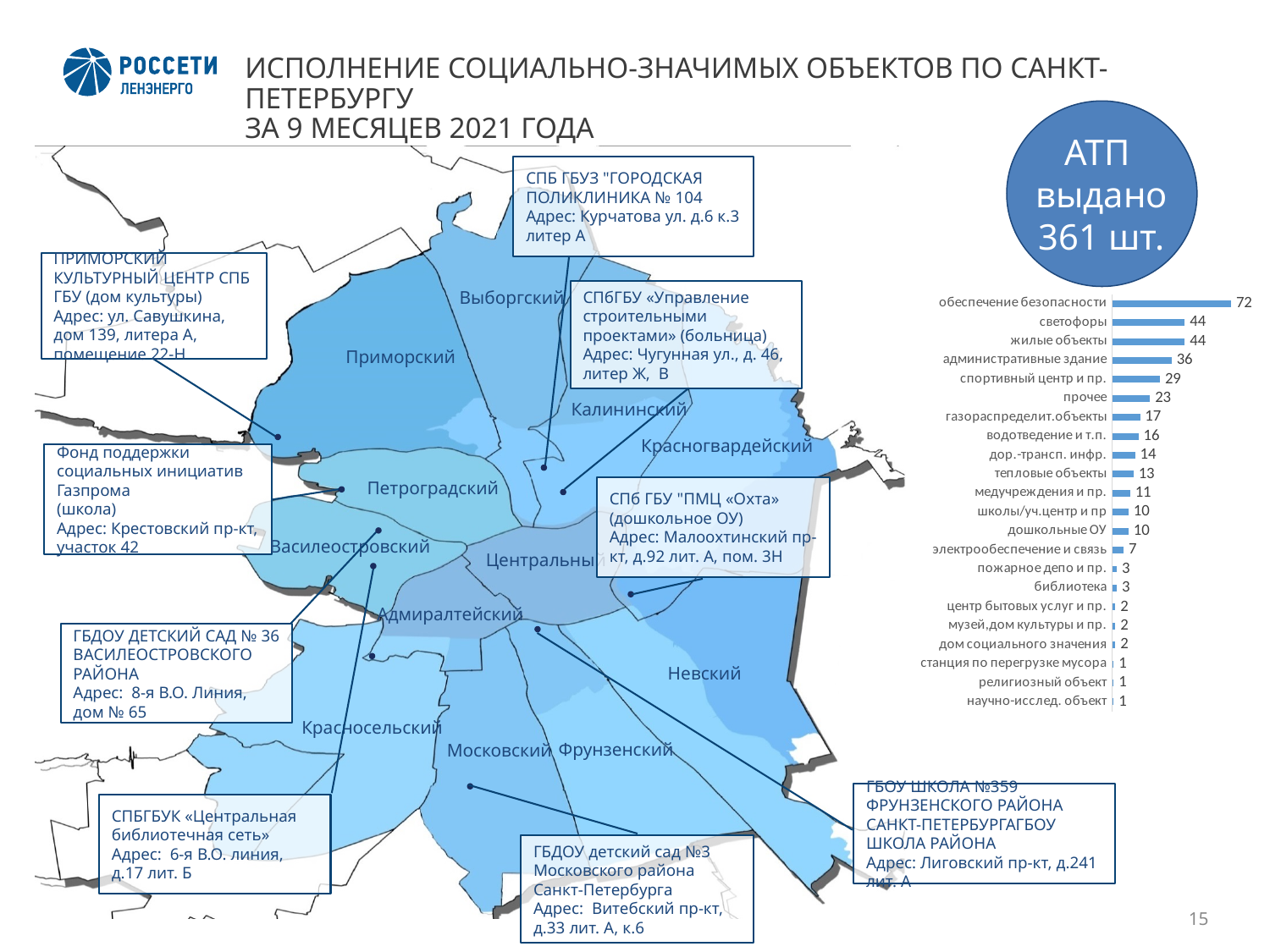
According to the circle above the chart, how many АТП were issued? 361 шт. Which category has the highest value in the bar chart? обеспечение безопасности Which is larger in the bar chart: водотведение и т.п. or тепловые объекты? водотведение и т.п. What is the difference between the values for обеспечение безопасности and светофоры? 28 What is the value for электрообеспечение и связь in the bar chart? 7 How many categories are shown in the bar chart? 22 What is the value for газораспределит.объекты in the bar chart? 17 Which is larger in the bar chart: медучреждения и пр. or дор.-трансп. инфр.? дор.-трансп. инфр. What is the value for обеспечение безопасности in the bar chart? 72 What kind of chart is shown on the slide? bar chart What is the value for административные здание in the bar chart? 36 What is the difference between the values for спортивный центр и пр. and прочее? 6